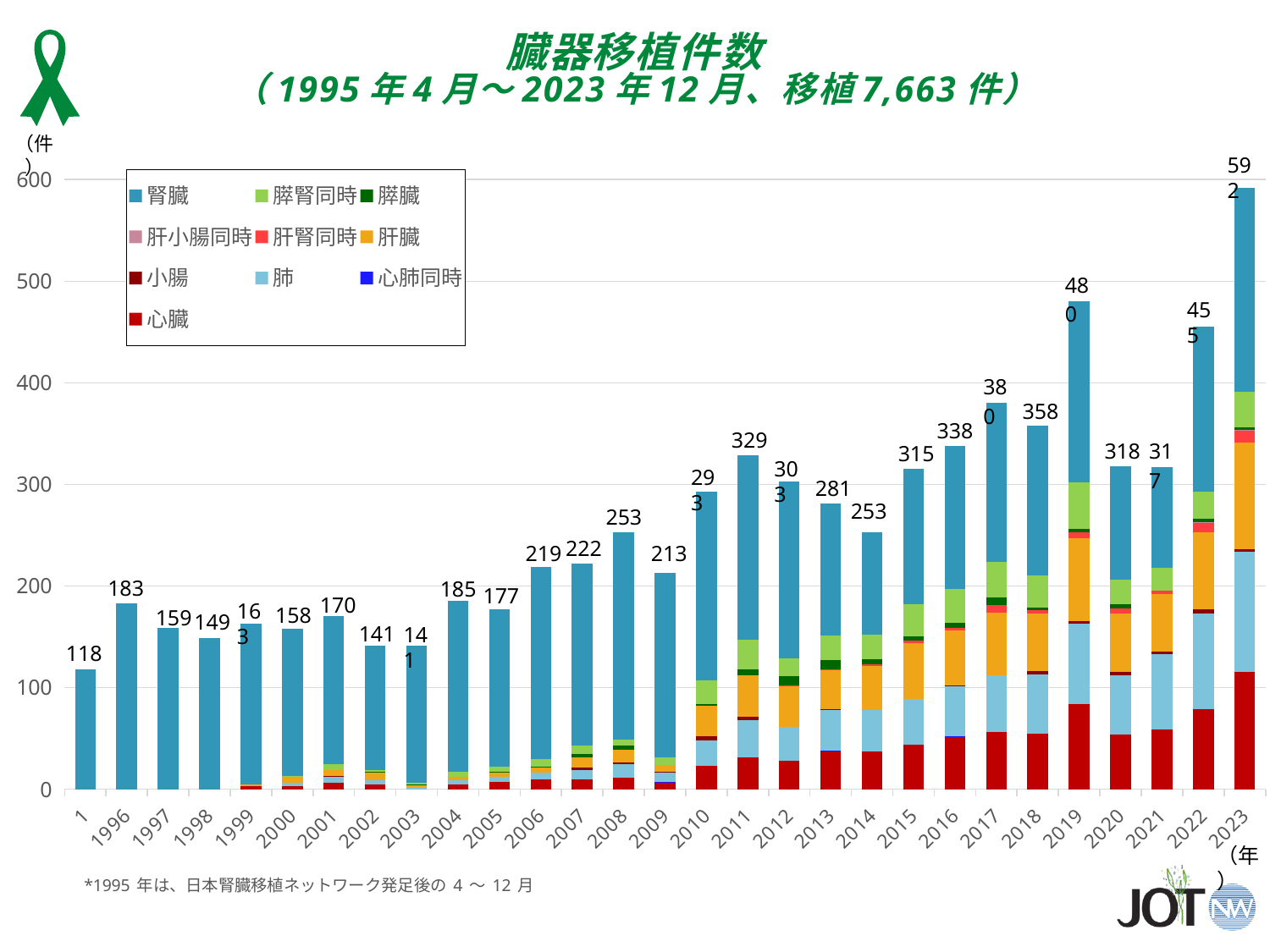
What is the difference between the totals for 2016 and 2015? 23 Which year has the lowest total number of transplants? 1995 How many series does the legend list? 10 Is the total for 2019 greater or less than 400? greater What is the total number of transplants shown for 2011? 329 Which year has a larger total, 2013 or 2014? 2013 Which year has the highest total number of transplants? 2023 Does the total rise or fall from 2019 to 2020? fall What is the total number of transplants shown for 2018? 358 How many years (bars) are shown on the x axis? 29 What is the total number of transplants shown for 2008? 253 What kind of chart is shown on the slide? stacked bar chart